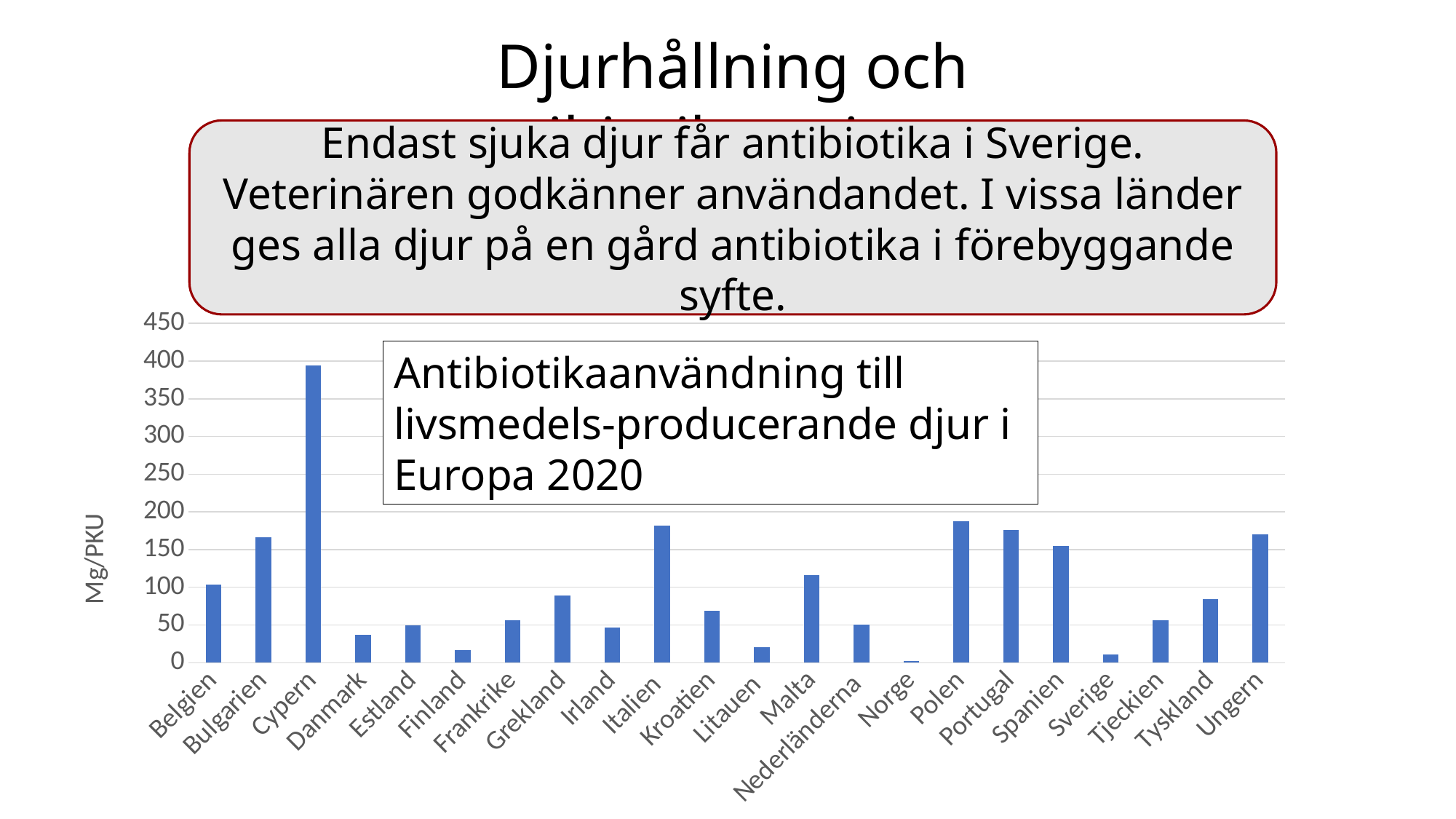
What is the label on the y axis of the chart? Mg/PKU Is the value for Cypern greater or less than 350? greater Is the value for Sverige greater or less than 50? less Is the value for Polen greater or less than 200? less What kind of chart is shown on the slide? bar chart How many countries are shown on the x axis of the chart? 22 Which country has the highest antibiotic use in the chart? Cypern Which has a higher value, Sverige or Tyskland? Tyskland Which country has the lowest antibiotic use in the chart? Norge Which has a higher value, Italien or Kroatien? Italien